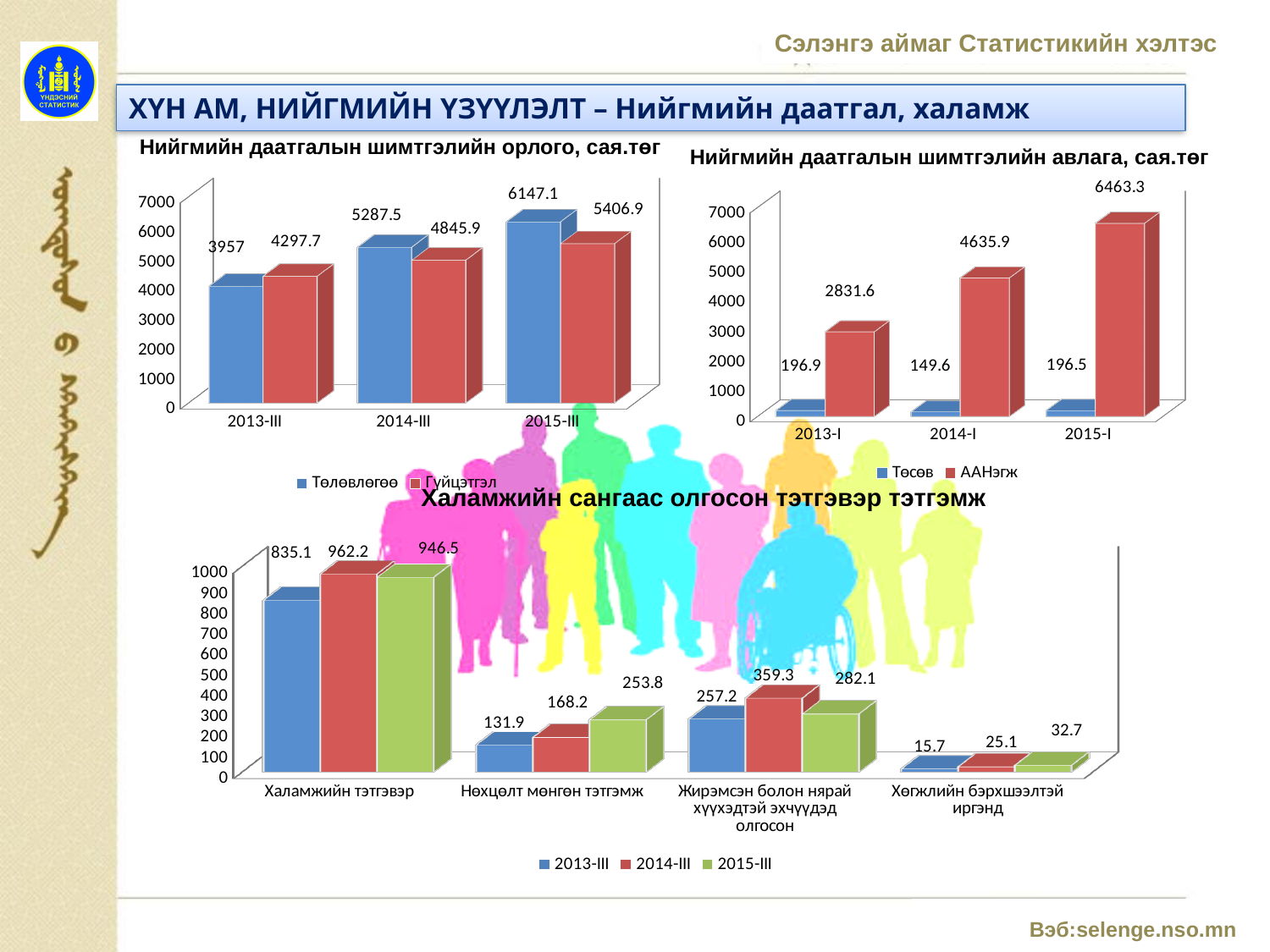
In the chart titled 'Нийгмийн даатгалын шимтгэлийн авлага, сая.төг', what is the difference between the ААНэгж values for 2014-I and 2013-I? 1804.3 What kind of chart is 'Халамжийн сангаас олгосон тэтгэвэр тэтгэмж'? bar chart In the chart titled 'Нийгмийн даатгалын шимтгэлийн орлого, сая.төг', which is larger for 2013-III: Төлөвлөгөө or Гүйцэтгэл? Гүйцэтгэл In the chart titled 'Нийгмийн даатгалын шимтгэлийн авлага, сая.төг', what is the ААНэгж value for 2015-I? 6463.3 In the chart titled 'Нийгмийн даатгалын шимтгэлийн орлого, сая.төг', does the Төлөвлөгөө value rise or fall from 2013-III to 2015-III? rise In the chart titled 'Нийгмийн даатгалын шимтгэлийн авлага, сая.төг', how many series does the legend list? 2 In the chart titled 'Халамжийн сангаас олгосон тэтгэвэр тэтгэмж', what is the 2015-III value for Нөхцөлт мөнгөн тэтгэмж? 253.8 In the chart titled 'Нийгмийн даатгалын шимтгэлийн орлого, сая.төг', what is the Гүйцэтгэл value for 2014-III? 4845.9 In the chart titled 'Нийгмийн даатгалын шимтгэлийн авлага, сая.төг', in which period is the Төсөв value lowest? 2014-I In the chart titled 'Нийгмийн даатгалын шимтгэлийн орлого, сая.төг', what is the difference between Төлөвлөгөө and Гүйцэтгэл for 2015-III? 740.2 In the chart titled 'Халамжийн сангаас олгосон тэтгэвэр тэтгэмж', which category has the highest 2014-III value? Халамжийн тэтгэвэр In the chart titled 'Халамжийн сангаас олгосон тэтгэвэр тэтгэмж', how many categories are shown on the x axis? 4